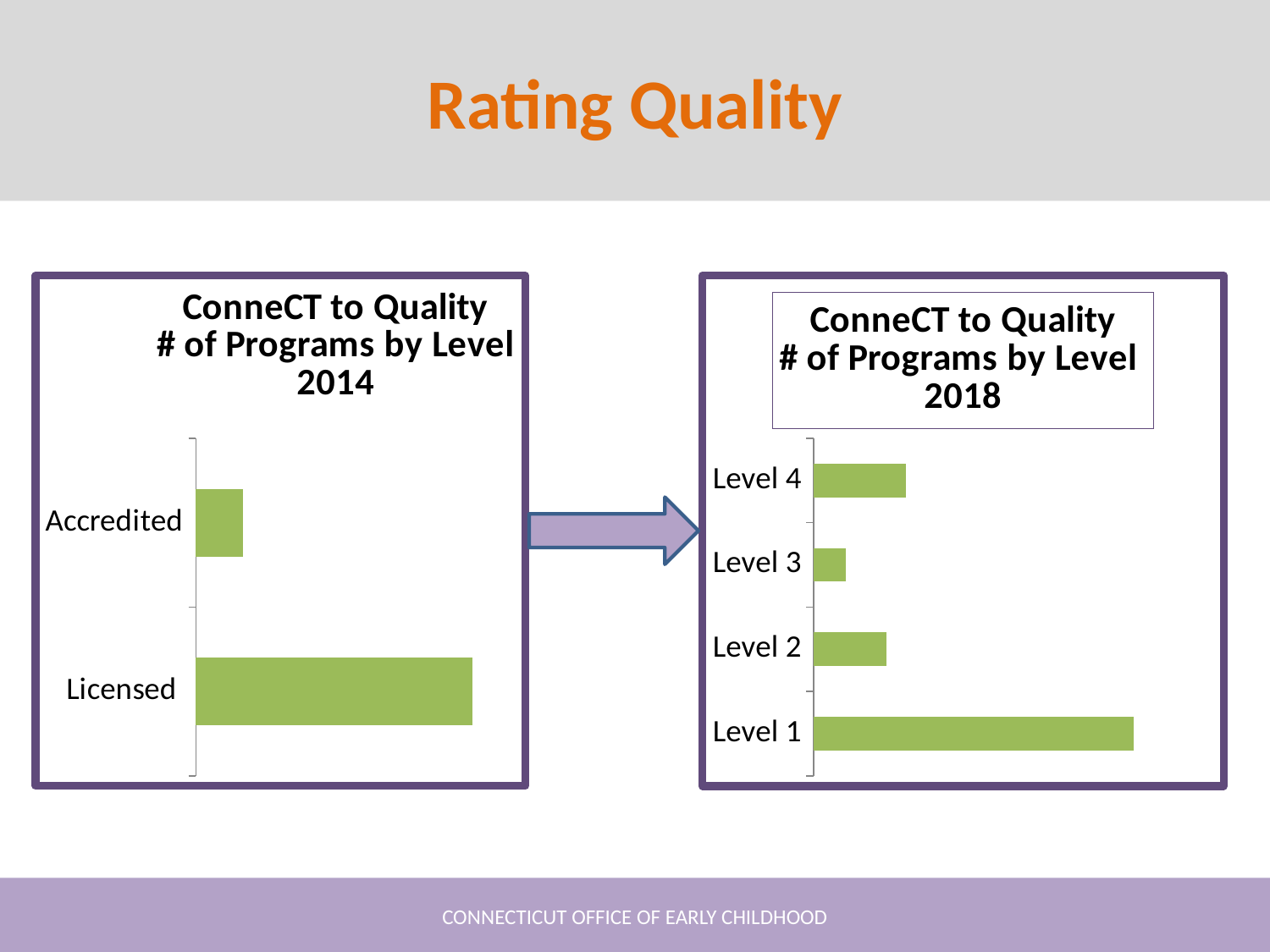
In the 2018 chart on the right, which level has the highest number of programs? Level 1 How many categories are shown in the 2014 chart on the left? 2 In the 2014 chart on the left, which has more programs, Accredited or Licensed? Licensed What kind of chart is the 2014 chart on the left? bar chart In the 2018 chart on the right, which has more programs, Level 4 or Level 3? Level 4 What kind of chart is the 2018 chart on the right? bar chart In the 2014 chart on the left, which category has the highest number of programs? Licensed In the 2014 chart on the left, which category has the lowest number of programs? Accredited In the 2018 chart on the right, which level has the lowest number of programs? Level 3 How many categories are shown in the 2018 chart on the right? 4 In the 2018 chart on the right, which has more programs, Level 2 or Level 3? Level 2 What is the title of the chart on the right? ConneCT to Quality # of Programs by Level 2018